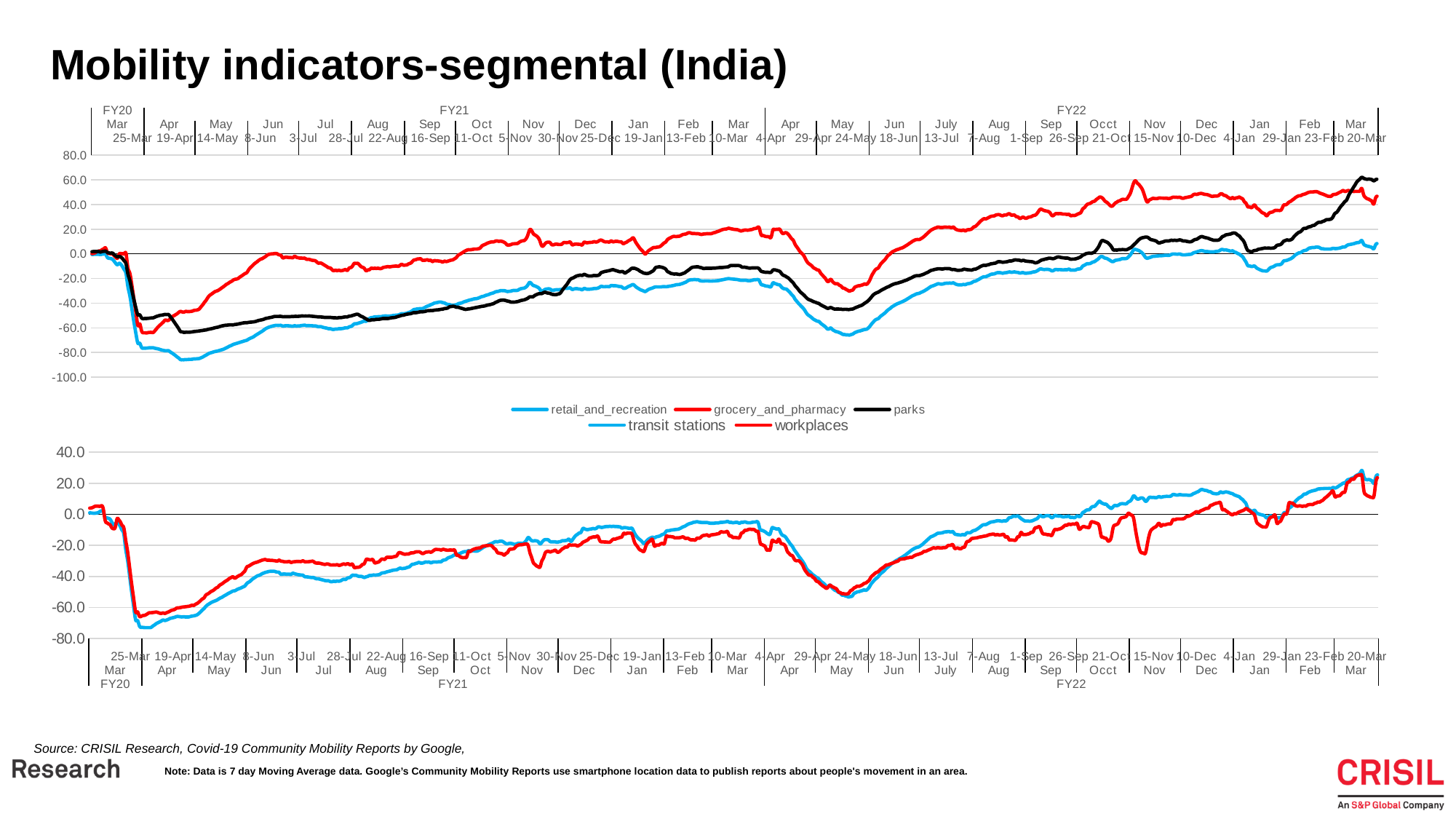
In the bottom chart, do the transit stations values rise or fall between 25-Mar (FY20) and 19-Apr (FY20)? fall In the top chart, which is larger at 24-May (FY21): grocery_and_pharmacy or retail_and_recreation? grocery_and_pharmacy In the top chart, what colour is the parks line? black How many series does the legend of the top chart list? 3 In the top chart, is the value for parks at 20-Mar (FY22) greater or less than 40? greater In the top chart, which series has the lowest value at 19-Apr (FY20)? retail_and_recreation In the bottom chart, is the value for workplaces at 20-Mar (FY22) greater or less than 0? greater In the top chart, which series has the highest value at 20-Mar (FY22)? parks What kind of chart is the top chart on the slide? line chart In the bottom chart, is the value for transit stations at 24-May (FY21) greater or less than -40? less How many series does the legend of the bottom chart list? 2